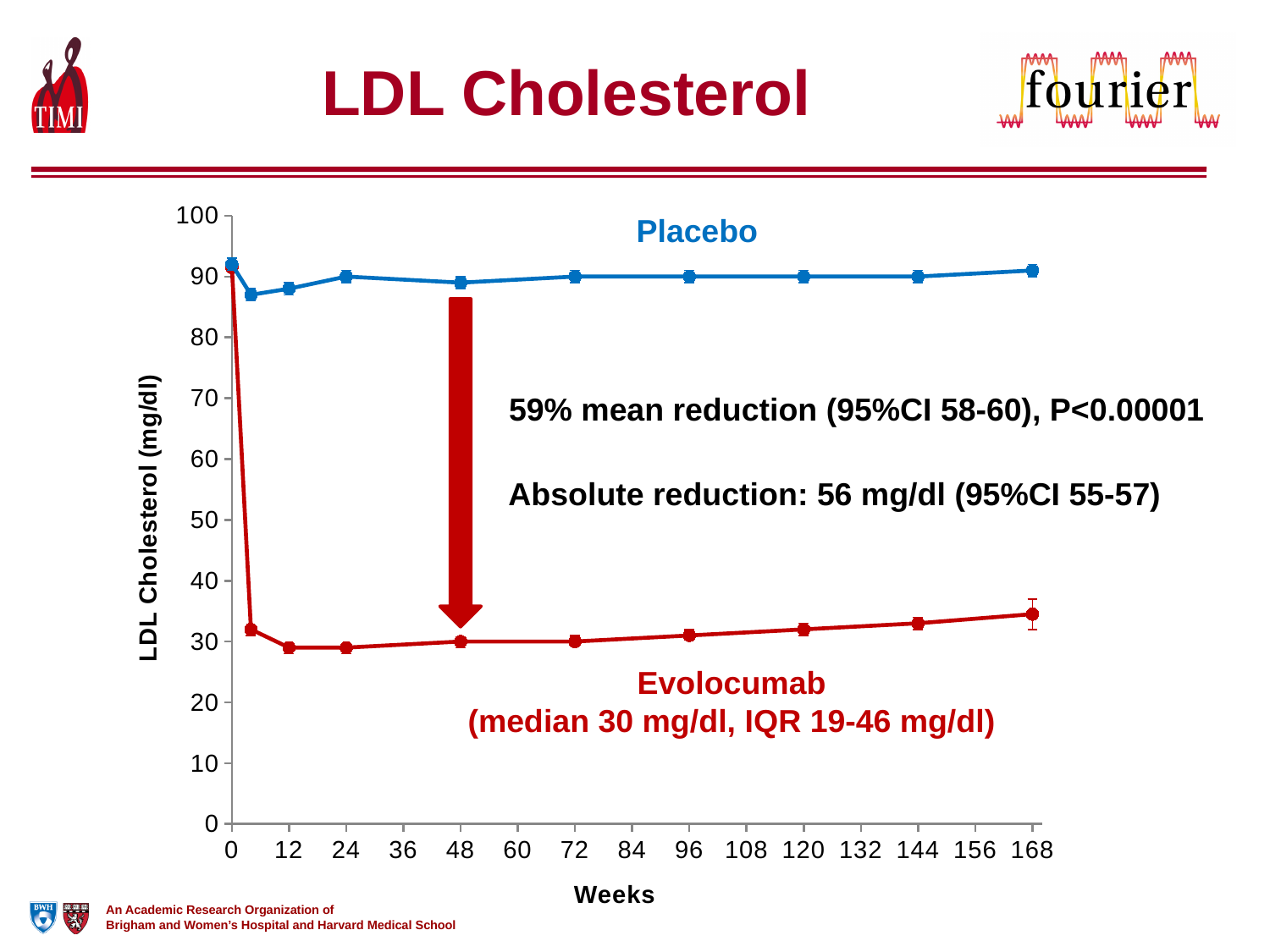
What kind of chart is shown on the slide? line chart Does the Evolocumab line rise or fall between 48 and 168 weeks? rise What is the label on the y axis of the chart? LDL Cholesterol (mg/dl) What absolute reduction in LDL cholesterol is stated on the chart? 56 mg/dl Is the Evolocumab value at 168 weeks greater or less than 40 mg/dl? less Which series has the higher LDL cholesterol value at 48 weeks, Placebo or Evolocumab? Placebo Is the Placebo value at 96 weeks greater or less than 80 mg/dl? greater Is the Evolocumab value at 168 weeks greater or less than 30 mg/dl? greater Does the Evolocumab line rise or fall between 0 and 4 weeks? fall How many series are plotted on the chart? 2